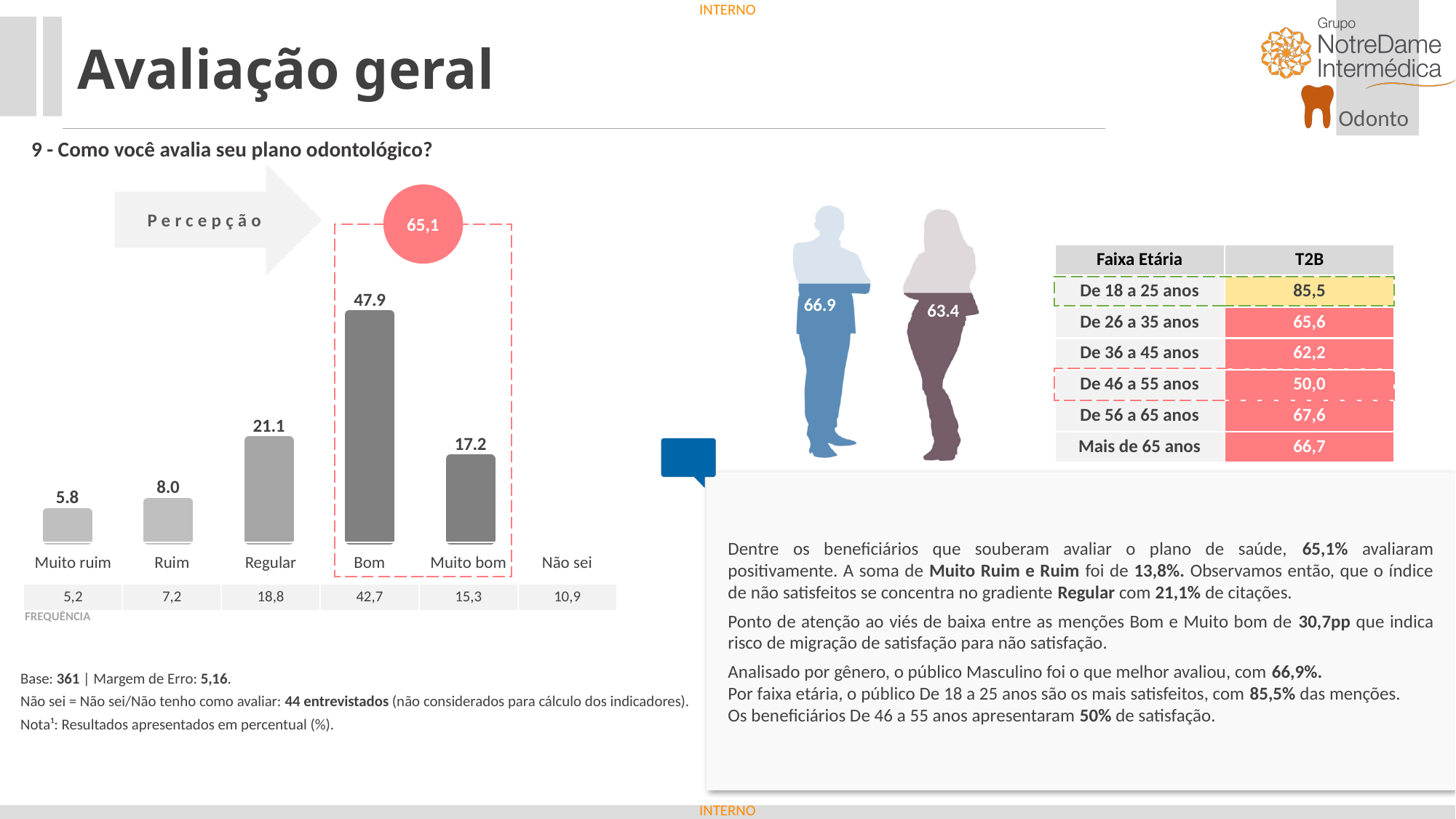
What is the value shown for the 'Regular' bar in the chart? 21.1 Which category has the highest bar in the chart? Bom What is the value shown for the 'Bom' bar in the chart? 47.9 What is the difference between the 'Bom' and 'Muito bom' values in the chart? 30.7 Which is larger in the chart, the value for 'Regular' or the value for 'Muito bom'? Regular What is the difference between the 'Regular' and 'Ruim' values in the chart? 13.1 How many bars are plotted in the chart? 5 What is the value shown for the 'Muito bom' bar in the chart? 17.2 What is the value shown for the 'Muito ruim' bar in the chart? 5.8 Which category has the lowest bar in the chart? Muito ruim What kind of chart is shown on the slide? Bar chart What value is shown in the red circle above the 'Bom' and 'Muito bom' bars? 65,1